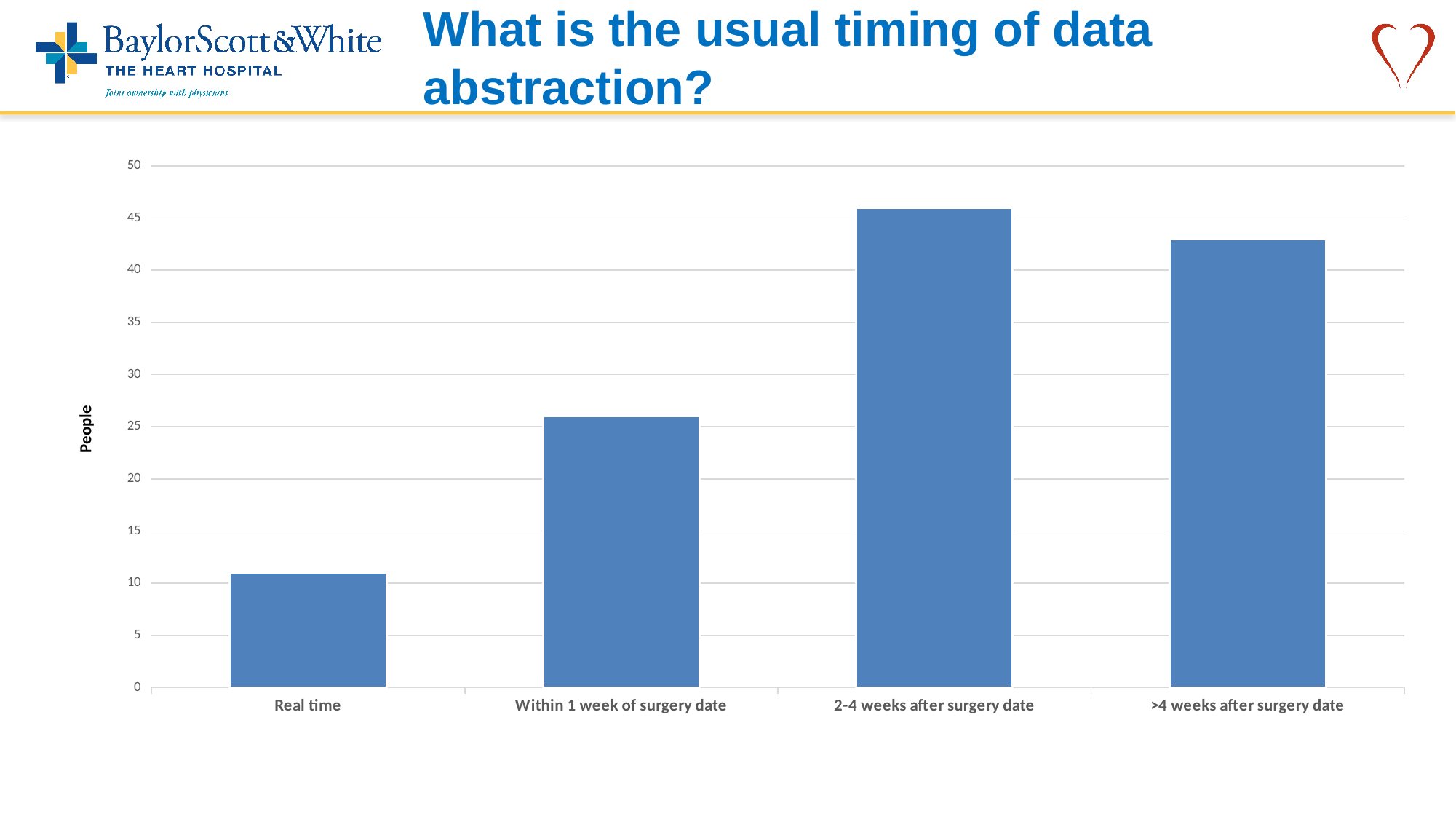
How many categories are shown on the x axis of the chart? 4 Is the value for >4 weeks after surgery date greater or less than 45? less Is the value for Real time greater or less than 15? less What is the label on the vertical axis of the chart? People Which is larger, the value for >4 weeks after surgery date or the value for Within 1 week of surgery date? >4 weeks after surgery date What kind of chart is shown on the slide? bar chart Which category has the highest value in the chart? 2-4 weeks after surgery date Is the value for Within 1 week of surgery date greater or less than 20? greater What question does the slide title ask? What is the usual timing of data abstraction? Which is larger, the value for Within 1 week of surgery date or the value for Real time? Within 1 week of surgery date Which category has the lowest value in the chart? Real time